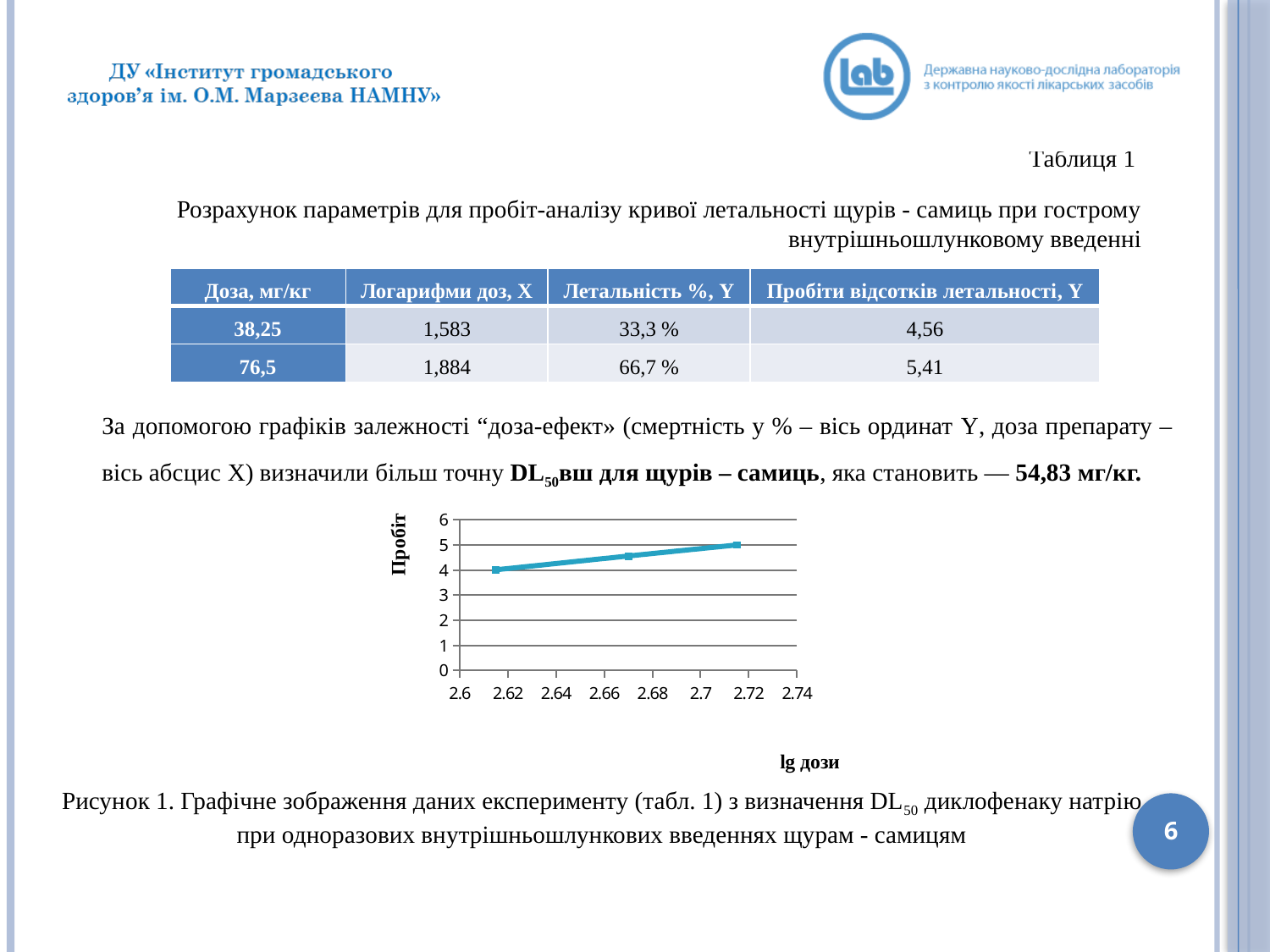
What is the label of the vertical axis of the chart? Пробіт Is the value of the middle point on the chart greater or less than 4? greater How many data points are plotted on the line chart? 3 What is the highest tick value shown on the horizontal axis of the chart? 2.74 Do the plotted values rise or fall as the x axis (lg дози) increases? rise What kind of chart is shown on the slide? line chart Is the value of the leftmost point on the chart greater or less than 3? greater What is the highest tick value shown on the vertical axis of the chart? 6 Is the value of the leftmost point on the chart greater or less than 5? less Which point on the chart has the highest value, the leftmost or the rightmost? rightmost What is the label of the horizontal axis of the chart? lg дози